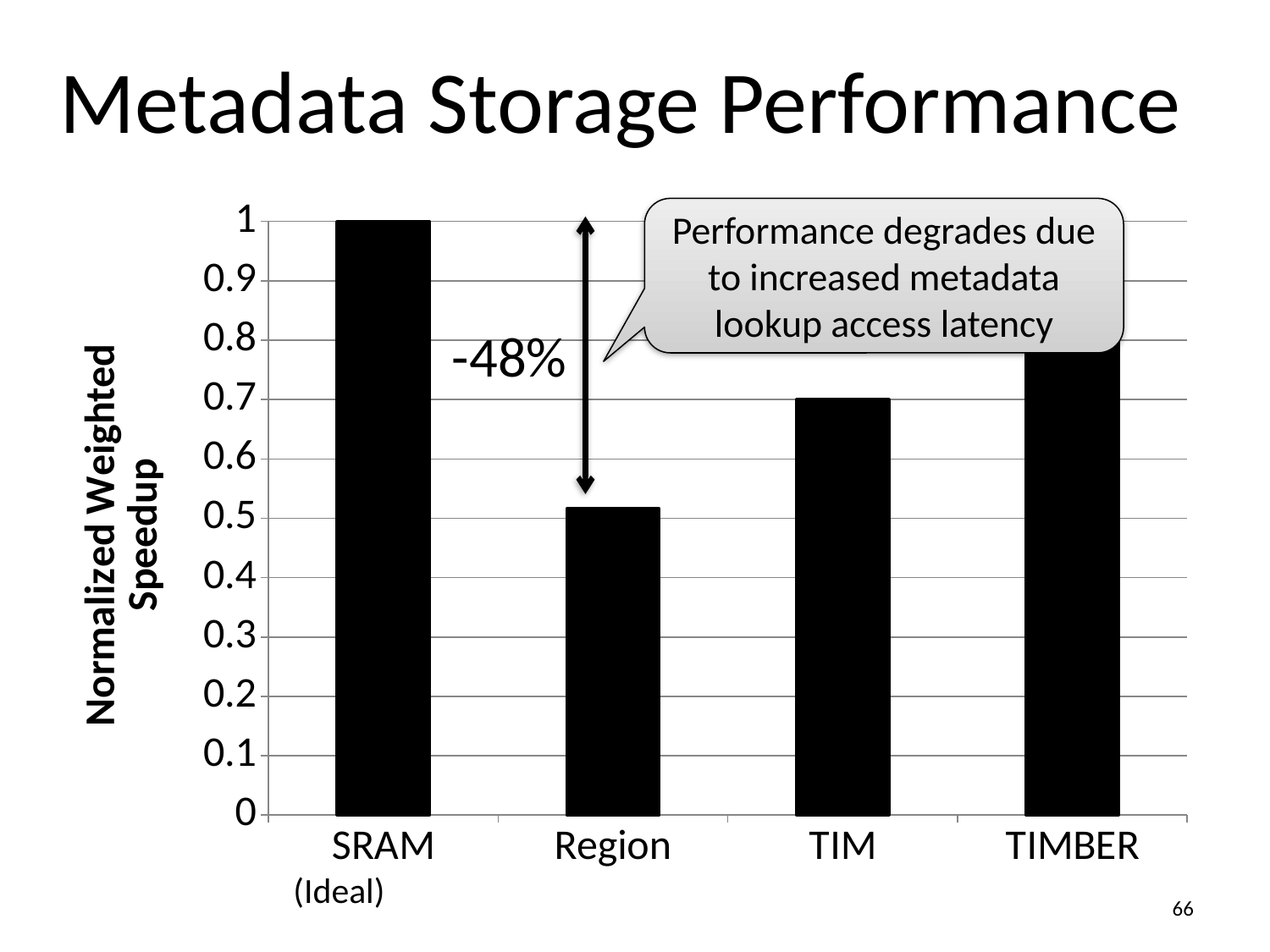
Is the value for Region greater or less than 0.5? greater Is the value for TIMBER greater or less than 0.7? greater Which category has the highest normalized weighted speedup? SRAM (Ideal) Which category has the lowest normalized weighted speedup? Region How many categories are plotted on the x axis? 4 What percentage change is annotated between the SRAM (Ideal) and Region bars? -48% What is the label of the y axis? Normalized Weighted Speedup What kind of chart is shown on the slide? bar chart What is the normalized weighted speedup for SRAM (Ideal)? 1 What is the normalized weighted speedup for TIM? 0.7 Is the value for Region greater or less than 0.6? less Which has a higher normalized weighted speedup, TIM or Region? TIM